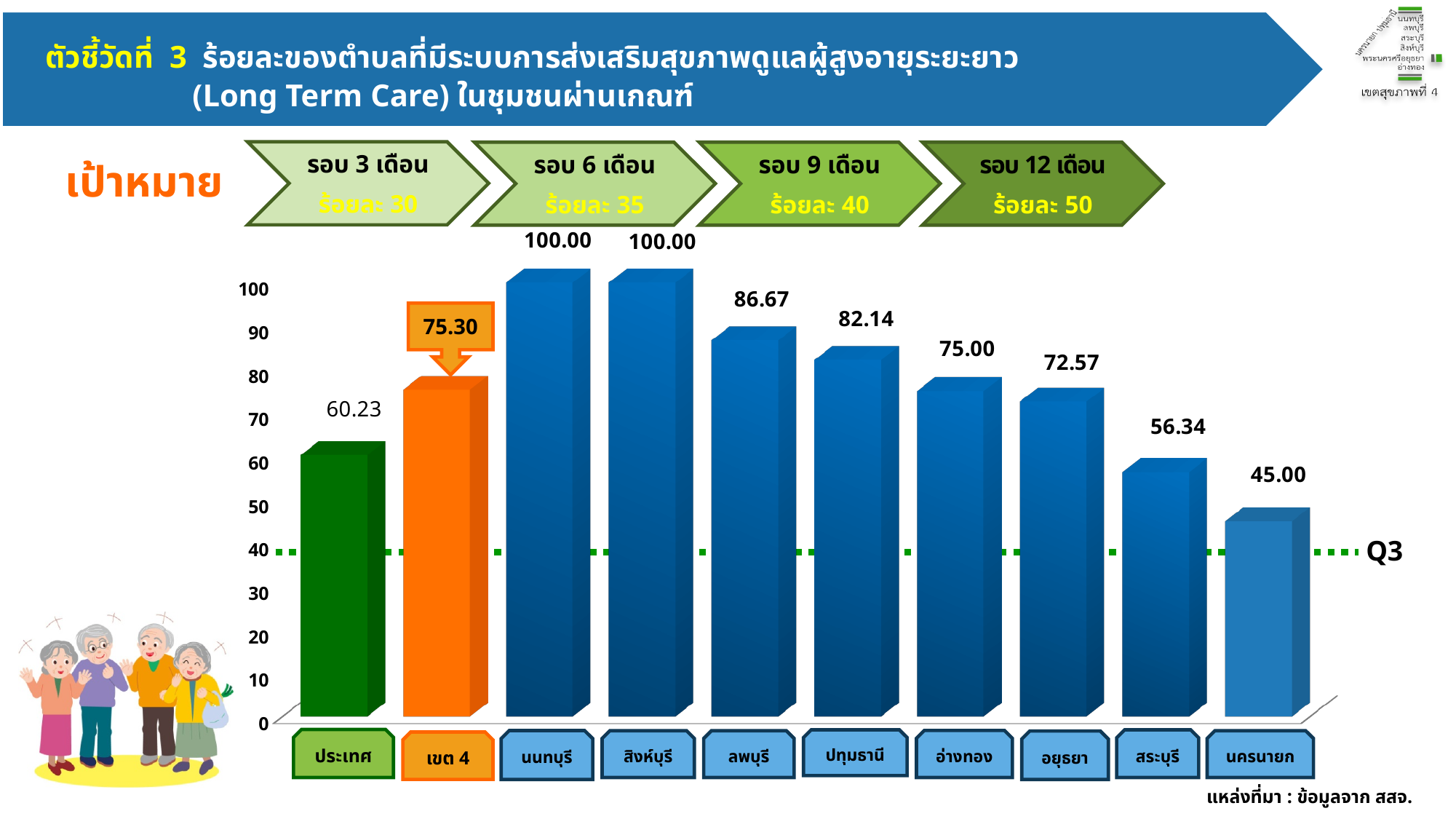
What is the difference between the values for ปทุมธานี and อยุธยา? 9.57 Is the value for นครนายก greater or less than 50? less What is the value for ลพบุรี? 86.67 At what value is the dotted Q3 line drawn? 40 Which category has the lowest value? นครนายก What is the value for นครนายก? 45.00 How many categories are shown on the x axis? 10 What kind of chart is shown on the slide? bar chart What is the value for เขต 4? 75.30 Which is larger, the value for สระบุรี or the value for อ่างทอง? อ่างทอง What is the value for ประเทศ? 60.23 What is the difference between the values for เขต 4 and ประเทศ? 15.07